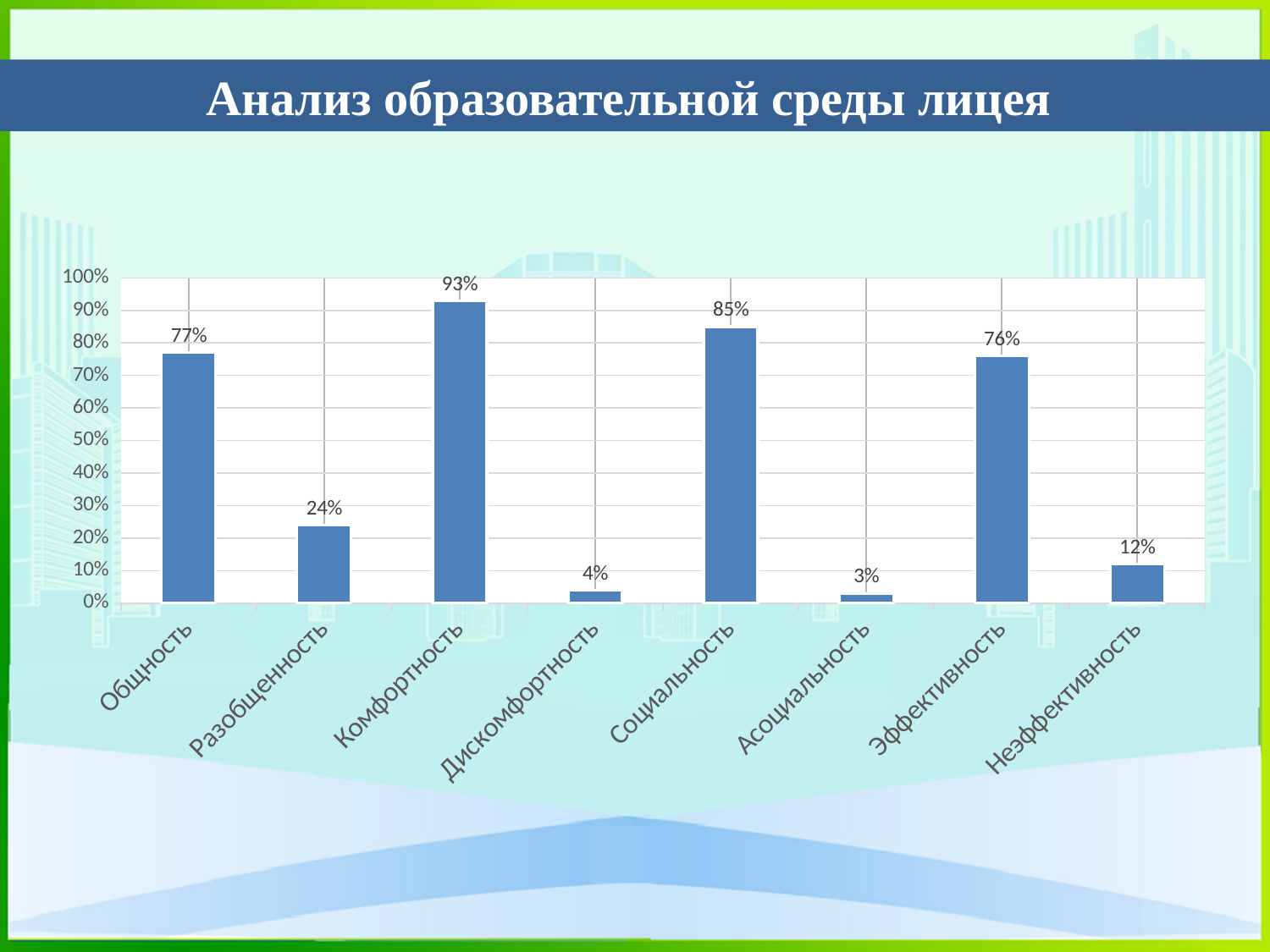
What is the value for Комфортность? 93% What is the value for Разобщенность? 24% What kind of chart is shown on the slide? bar chart Which is larger, the value for Общность or the value for Эффективность? Общность Is the value for Социальность greater or less than 80%? greater Which category has the highest value? Комфортность What is the difference between the values for Общность and Разобщенность? 53% What is the difference between the values for Социальность and Асоциальность? 82% What is the title of the slide? Анализ образовательной среды лицея How many categories are shown on the x axis? 8 What is the value for Неэффективность? 12% Which category has the lowest value? Асоциальность